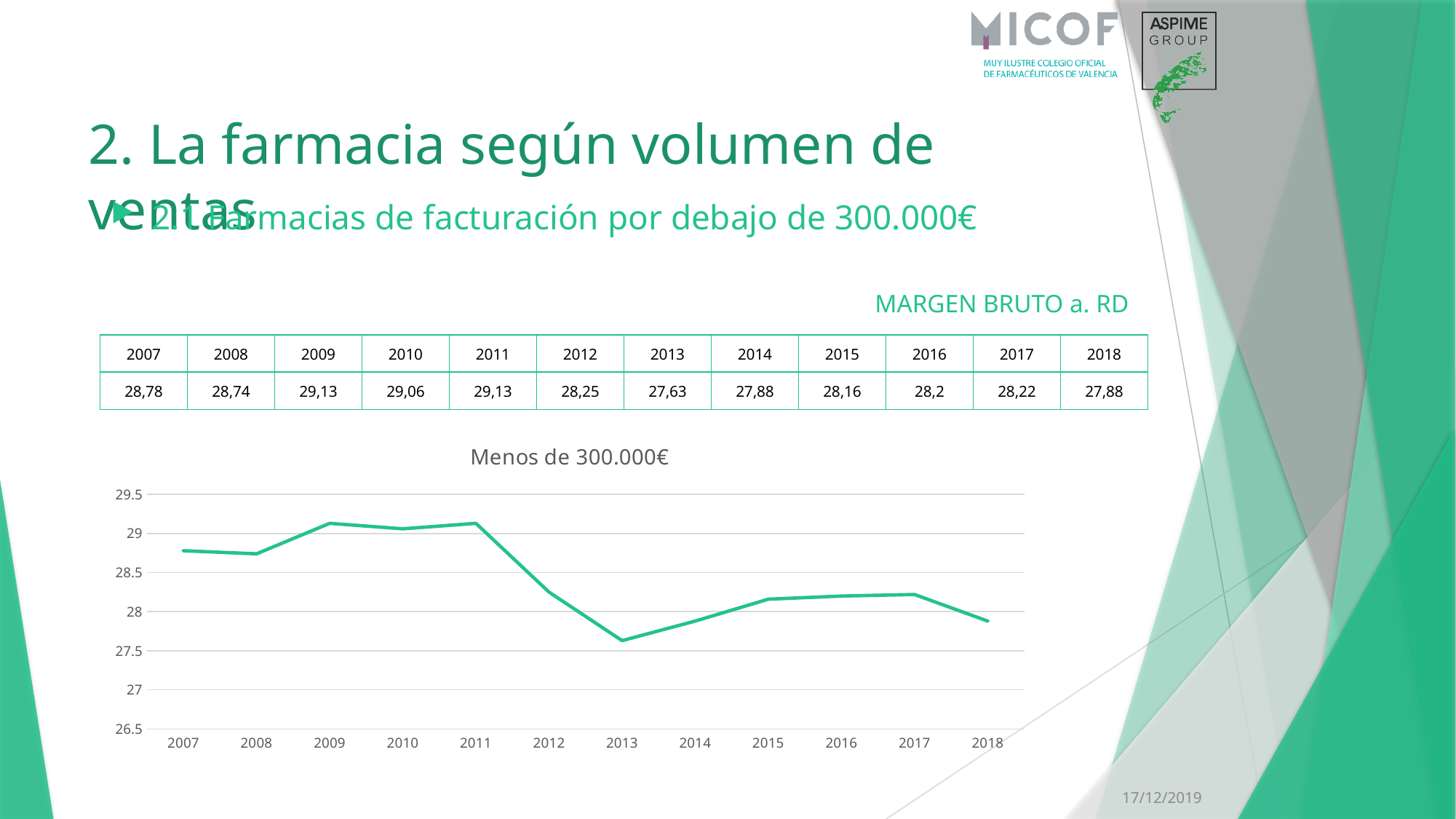
What kind of chart is the chart titled "Menos de 300.000€"? line chart Is the value for 2013 in the chart titled "Menos de 300.000€" greater or less than 28? less Which year has the lowest value in the chart titled "Menos de 300.000€"? 2013 What is the value for 2013 in the chart titled "Menos de 300.000€"? 27,63 What is the difference between the values for 2007 and 2018 in the chart titled "Menos de 300.000€"? 0,9 Do the values in the chart titled "Menos de 300.000€" rise or fall from 2011 to 2013? fall Which year has the larger value in the chart titled "Menos de 300.000€", 2009 or 2012? 2009 What is the highest value shown in the chart titled "Menos de 300.000€"? 29,13 How many years are plotted in the chart titled "Menos de 300.000€"? 12 What is the value for 2007 in the chart titled "Menos de 300.000€"? 28,78 What is the difference between the values for 2011 and 2013 in the chart titled "Menos de 300.000€"? 1,5 What is the value for 2018 in the chart titled "Menos de 300.000€"? 27,88